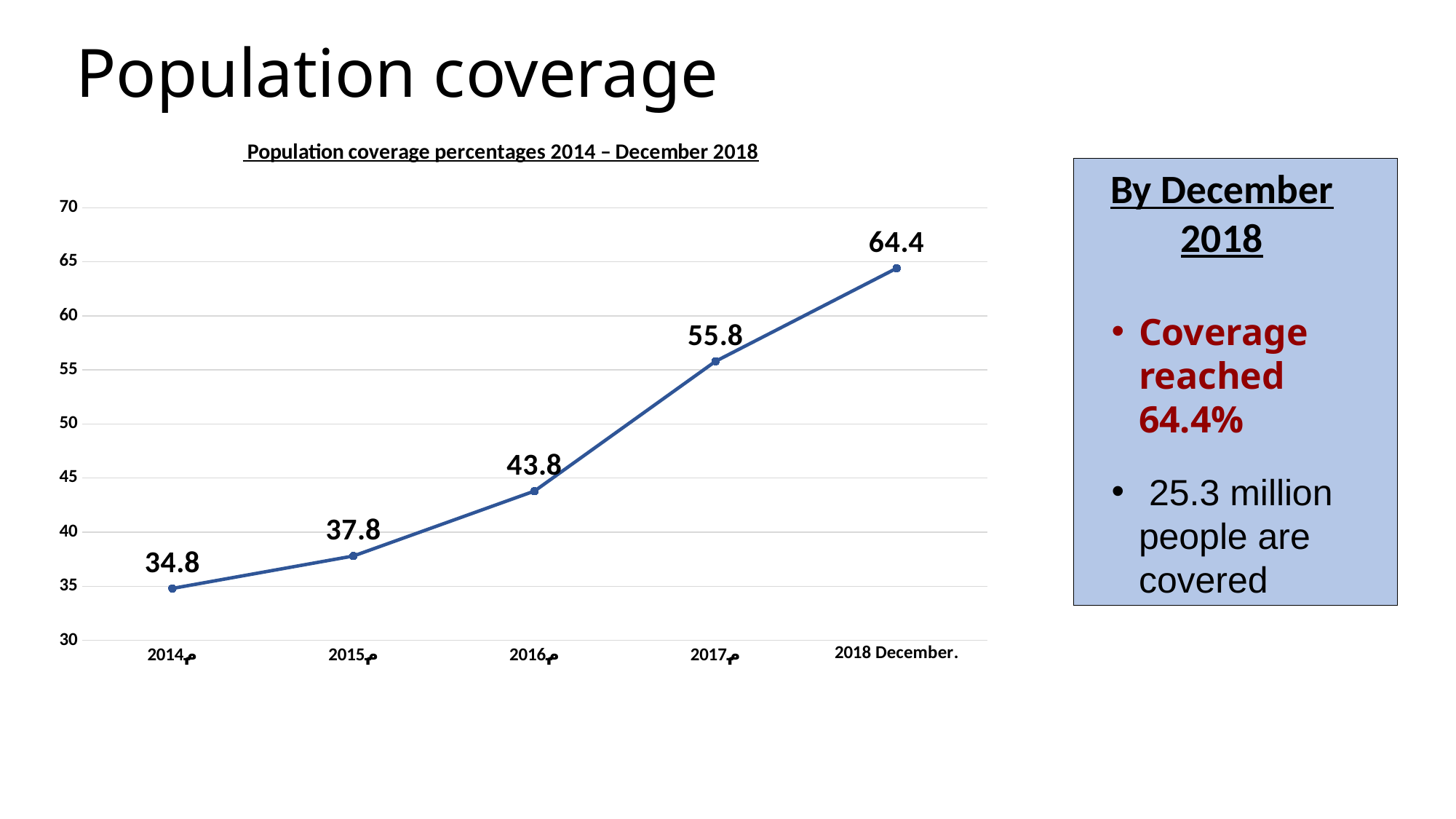
Which is larger, the coverage percentage in 2016 or in 2017? 2017 What is the difference between the coverage percentage in December 2018 and in 2017? 8.6 Which year has the lowest population coverage percentage? 2014 What is the population coverage percentage for December 2018? 64.4 What is the difference between the coverage percentage in 2015 and in 2014? 3 What is the population coverage percentage for 2016? 43.8 What is the population coverage percentage for 2014? 34.8 How many data points are plotted on the chart? 5 Is the coverage percentage for 2017 greater or less than 50? greater Which year has the highest population coverage percentage? 2018 December What kind of chart is shown on the slide? line chart Do the coverage percentages rise or fall from 2014 to December 2018? rise